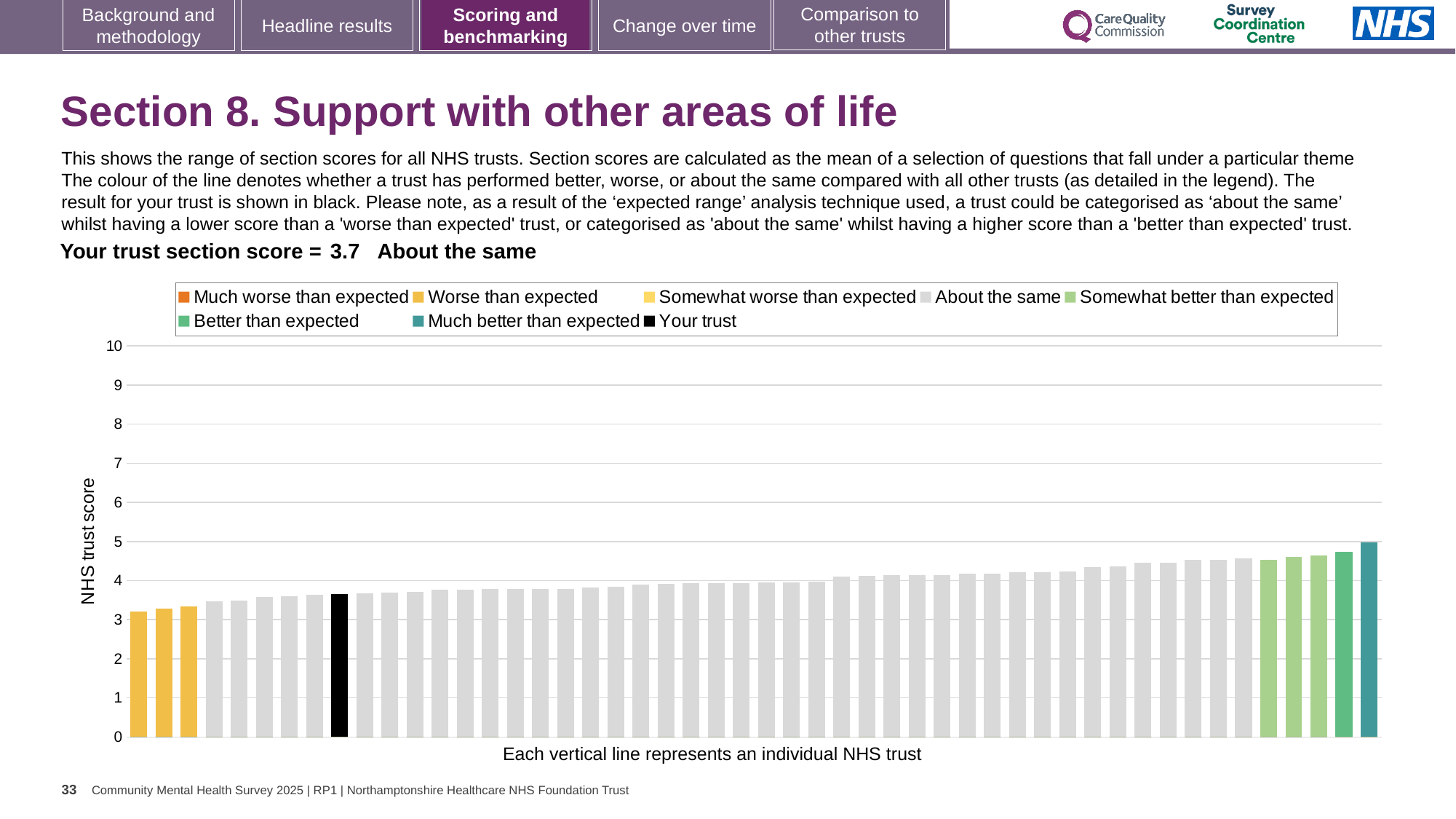
What is the label on the vertical axis of the chart? NHS trust score How many entries does the chart legend list? 8 What kind of chart is shown on the slide? bar chart What is the section score for your trust shown on the slide? 3.7 Is the value of the tallest bar greater or less than 6? less Is the value of the tallest bar (the 'Much better than expected' trust) greater or less than 4? greater Which performance category is your trust placed in for this section? About the same Is the value of the black 'Your trust' bar greater or less than 3? greater How many bars are coloured as 'Much better than expected' (teal)? 1 Do the bar values rise or fall from left to right along the x axis? rise How many bars are coloured as 'Worse than expected' (yellow)? 3